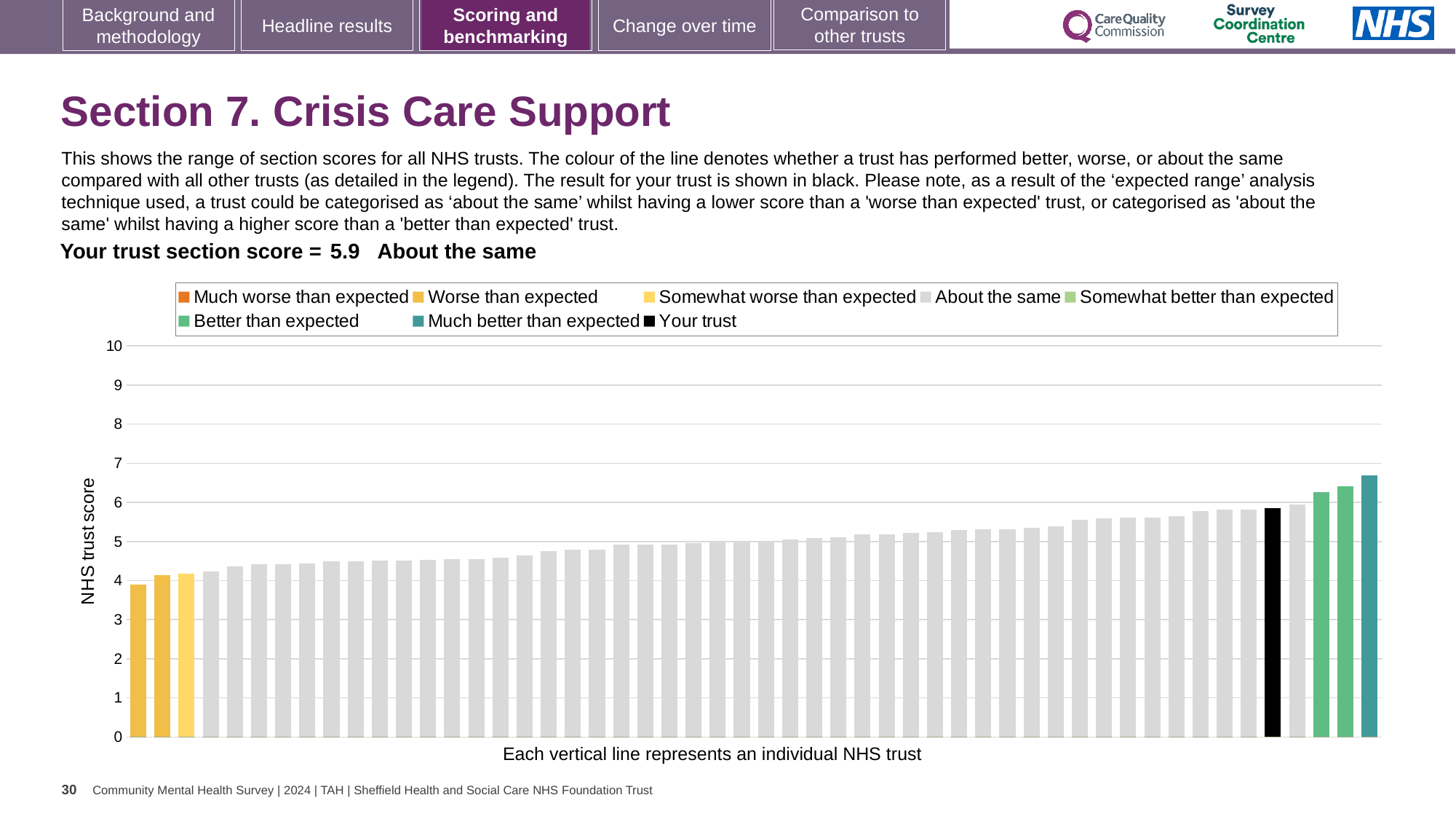
What colour is the bar representing your trust? black How many entries does the chart legend list? 8 Is the value of the shortest bar greater or less than 5? less Is the value for your trust greater or less than 5? greater Which performance category is your trust placed in for this section? About the same What is the section score for your trust shown on the slide? 5.9 Which is larger: the value for your trust or the value of the rightmost bar? the rightmost bar Is the value of the tallest bar greater or less than 6? greater What kind of chart is shown on the slide? bar chart Do the bar values rise or fall from left to right along the x axis? rise How many bars are coloured teal (Much better than expected)? 1 What is the highest value shown on the y axis? 10